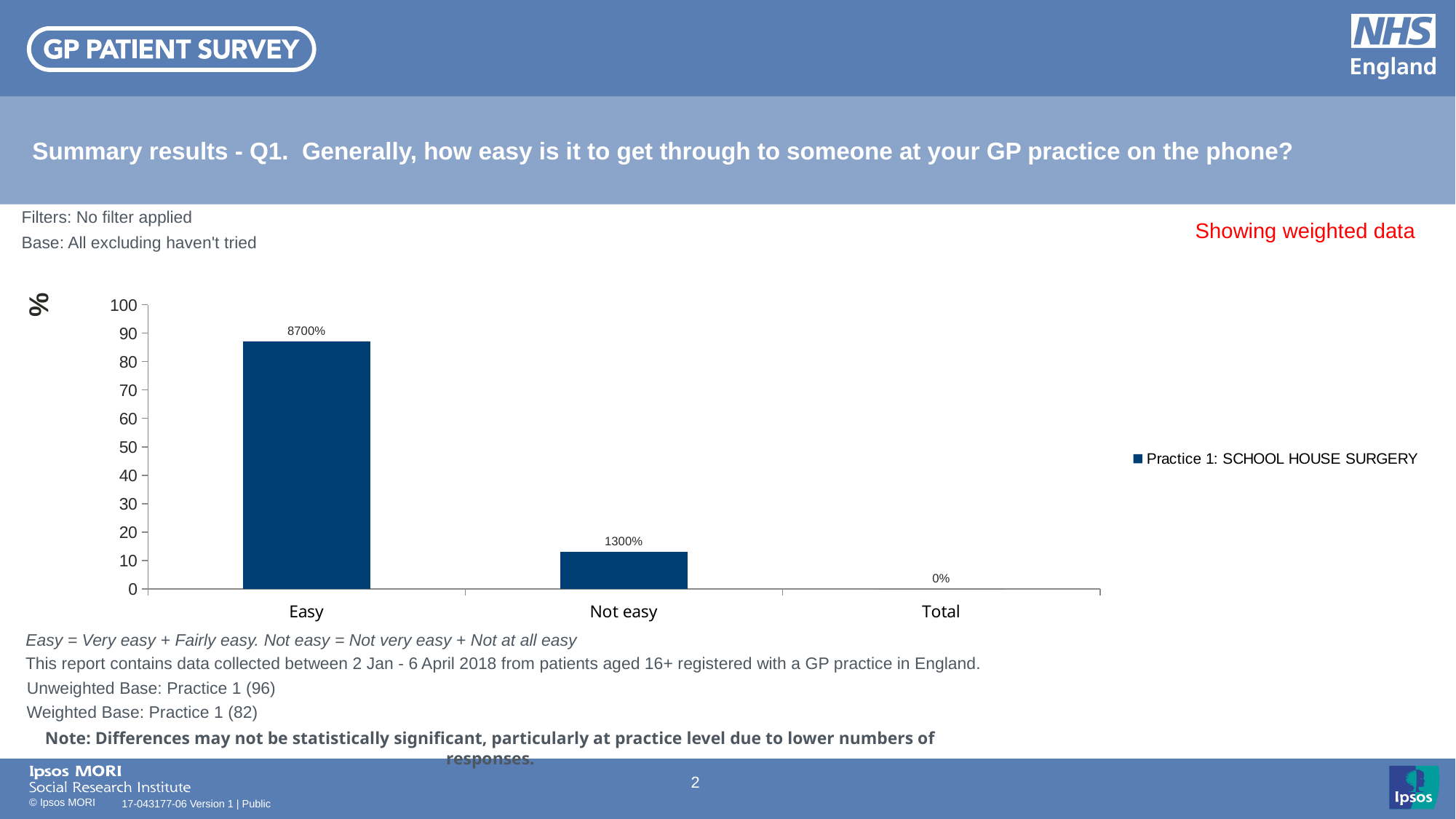
What is the data label shown for the Not easy bar? 1300% How many categories are shown on the x axis? 3 Which is larger, the value for Easy or the value for Not easy? Easy Is the value for Easy greater or less than 80 on the axis? greater Which category has the highest bar? Easy What is the name of the series in the legend? Practice 1: SCHOOL HOUSE SURGERY What is the data label shown for the Easy bar? 8700% What is the data label shown for the Total category? 0% How many series does the legend list? 1 Is the value for Not easy greater or less than 20 on the axis? less What kind of chart is shown on the slide? Bar chart Which category has the lowest value? Total